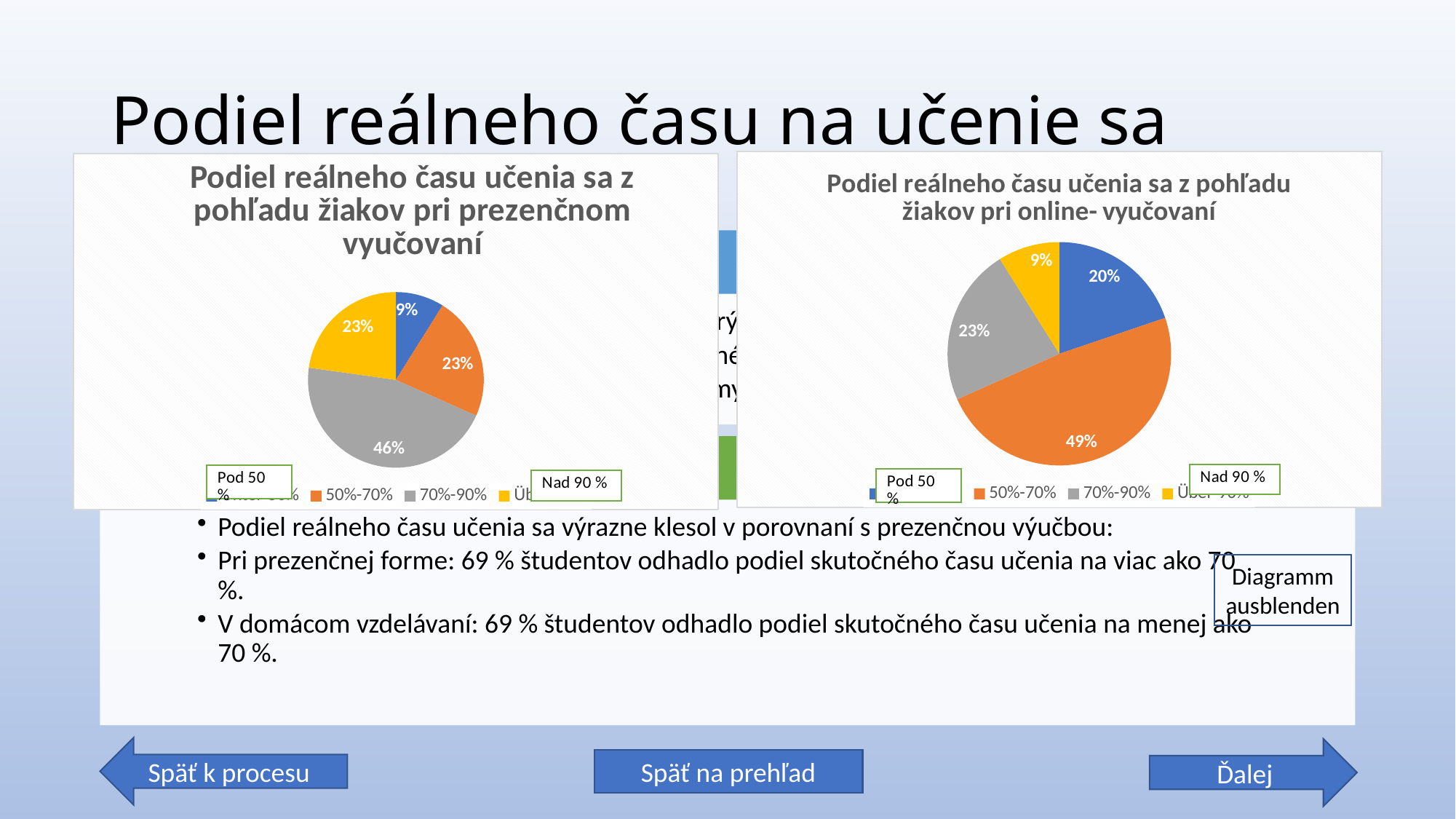
How many slices does the right pie chart (online- vyučovaní) have? 4 In the right pie chart (online- vyučovaní), what share is labelled for the 50%-70% slice? 49% In the left pie chart (prezenčnom vyučovaní), what share is labelled for the 70%-90% slice? 46% In the right pie chart (online- vyučovaní), what is the difference between the 50%-70% slice and the 70%-90% slice? 26% In the left pie chart (prezenčnom vyučovaní), which is larger: the 50%-70% slice or the Pod 50 % slice? 50%-70% What type of chart is the left chart (prezenčnom vyučovaní)? Pie chart In the right pie chart (online- vyučovaní), what share is labelled for the Pod 50 % slice? 20% In the left pie chart (prezenčnom vyučovaní), which category has the largest slice? 70%-90% In the right pie chart (online- vyučovaní), which category has the smallest slice? Nad 90 % In the left pie chart (prezenčnom vyučovaní), what is the combined share of the 70%-90% and Nad 90 % slices? 69% In the left pie chart (prezenčnom vyučovaní), what share is labelled for the Pod 50 % slice? 9% What colour is the 50%-70% slice in the right pie chart (online- vyučovaní)? Orange